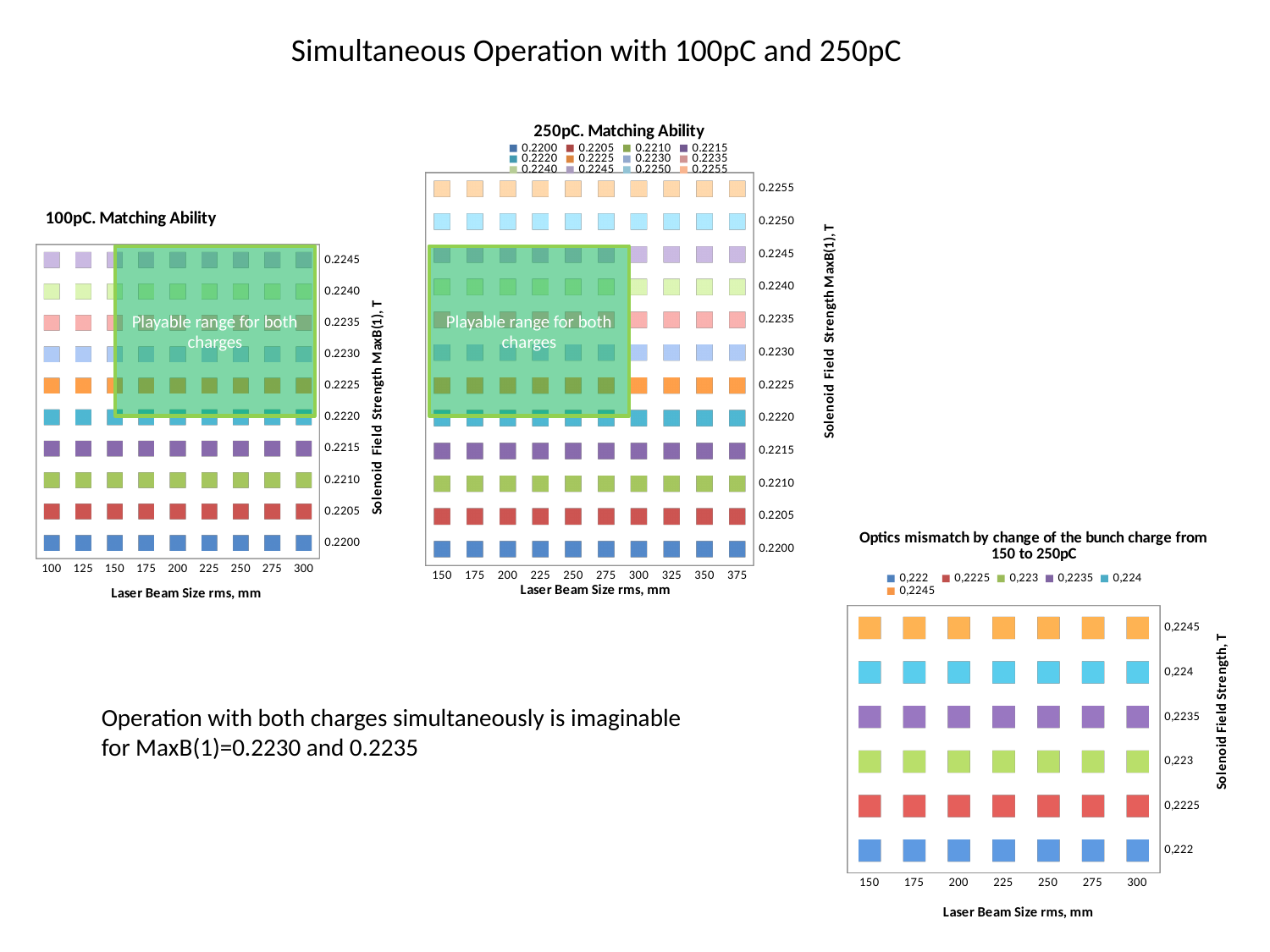
What kind of chart is the '100pC. Matching Ability' chart? scatter chart In the 'Optics mismatch' chart, what colour are the markers of the 0,2245 series? orange In the '250pC. Matching Ability' chart, what is the largest laser beam size on the x axis? 375 How many laser beam size values are shown on the x axis of the '100pC. Matching Ability' chart? 9 How many series does the legend of the '250pC. Matching Ability' chart list? 12 How many laser beam size values are shown on the x axis of the 'Optics mismatch' chart? 7 In the '250pC. Matching Ability' chart, what is the highest solenoid field strength value plotted? 0.2255 How many series does the legend of the 'Optics mismatch by change of the bunch charge from 150 to 250pC' chart list? 6 In the '100pC. Matching Ability' chart, what is the lowest solenoid field strength value plotted? 0.2200 How many laser beam size values are shown on the x axis of the '250pC. Matching Ability' chart? 10 What is the y-axis title of the 'Optics mismatch' chart? Solenoid Field Strength, T